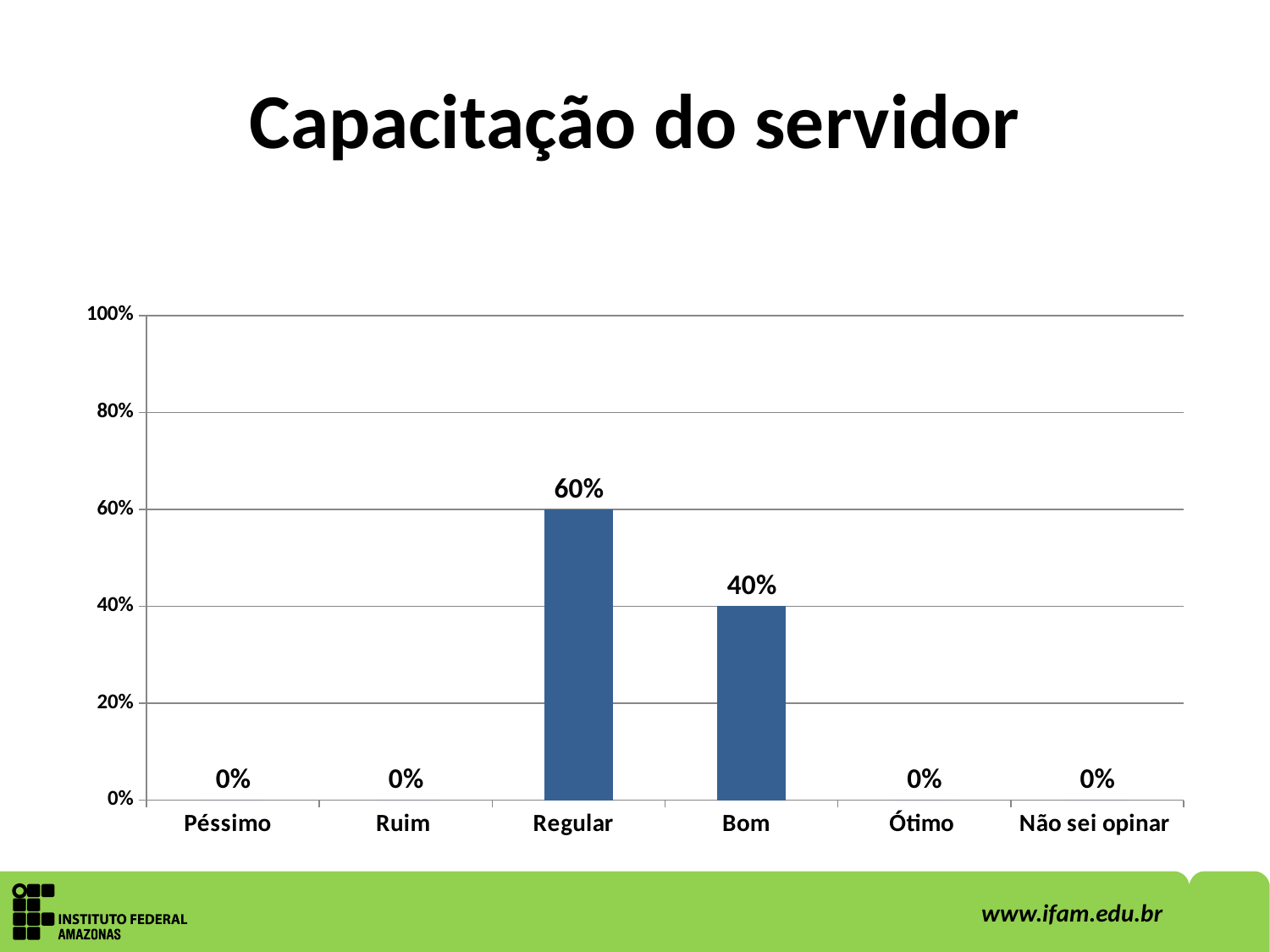
Which is larger, the value for Regular or the value for Bom? Regular How many categories are shown on the x axis? 6 What is the value for Não sei opinar? 0% What is the value for Péssimo? 0% What is the difference between the values for Regular and Bom? 20% Is the value for Regular greater or less than 40%? greater What is the value for Bom? 40% Which category has the highest value? Regular What kind of chart is shown on the slide? bar chart What is the value for Regular? 60% What is the total of the values for Regular and Bom? 100% What is the title of the slide? Capacitação do servidor